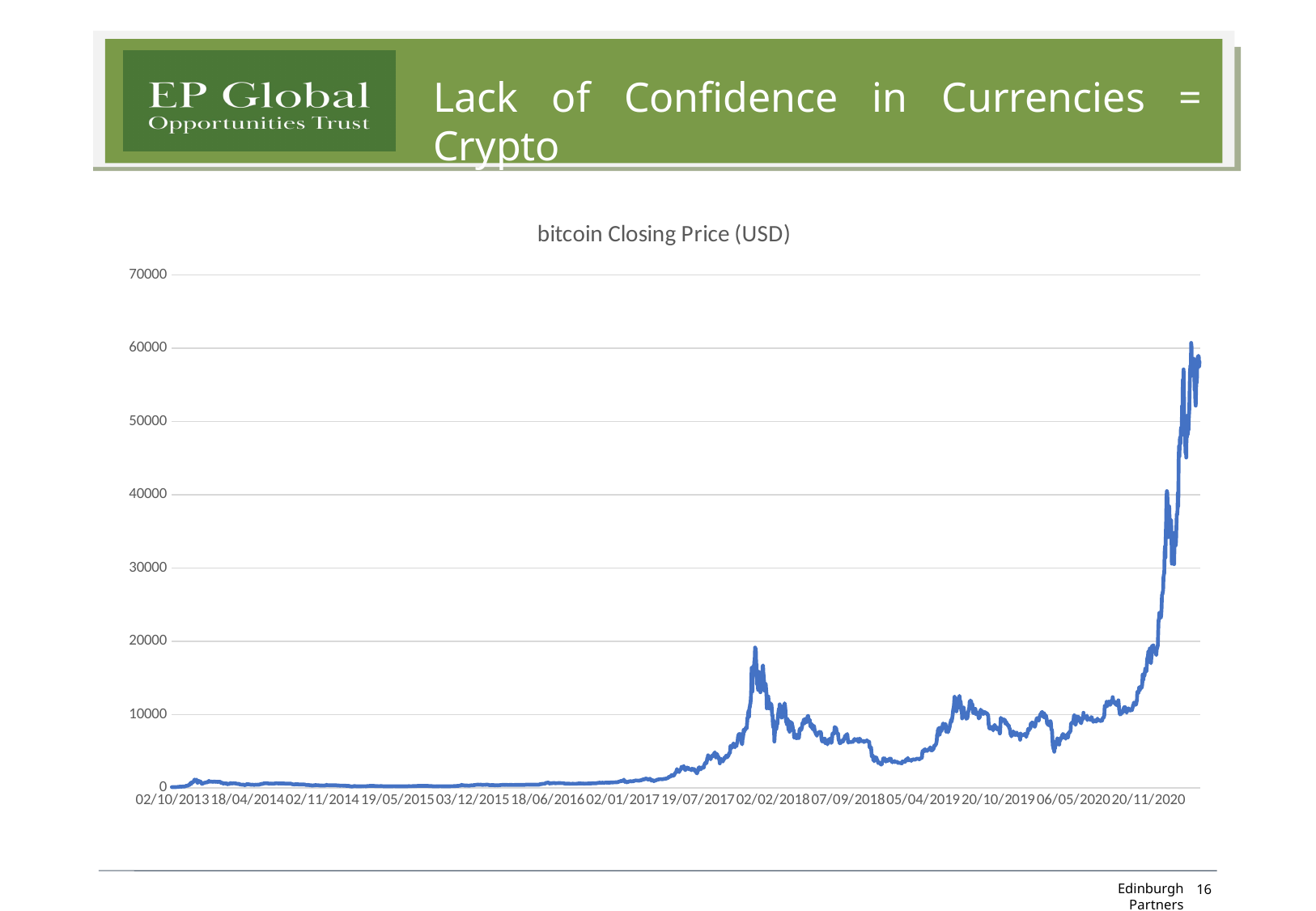
Is the bitcoin closing price higher at the end of the chart or at 02/10/2013? at the end of the chart Is the peak of the bitcoin closing price in late 2017 greater or less than 30000? less What is the highest value shown on the y axis? 70000 How many date labels are shown on the x axis? 14 Is the bitcoin closing price at 20/11/2020 greater or less than 10000? greater Overall, does the bitcoin closing price rise or fall from left to right across the chart? rise Is the highest value reached by the bitcoin closing price greater or less than 50000? greater What is the title of the chart? bitcoin Closing Price (USD) What kind of chart is shown on the slide? line chart